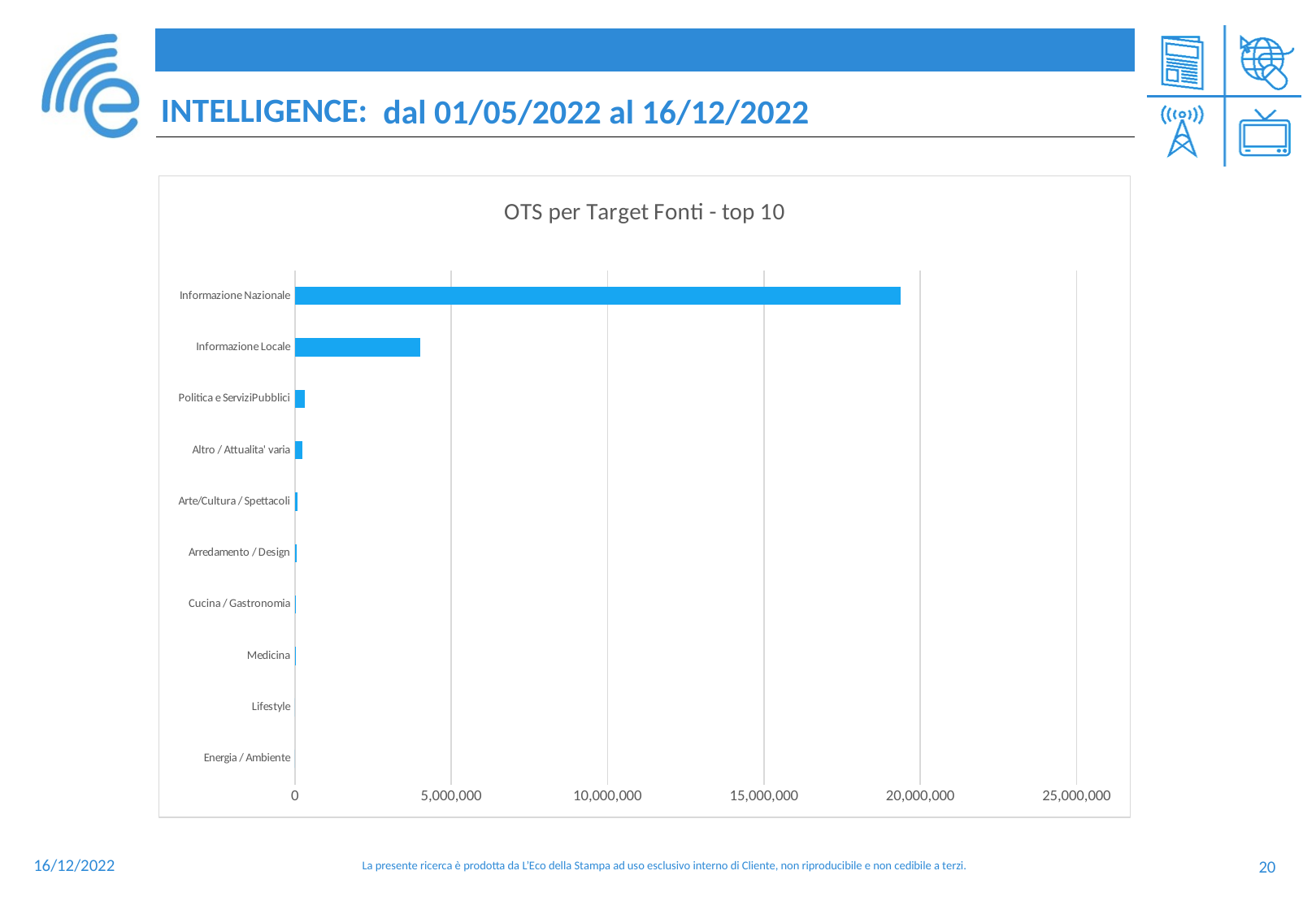
Which is larger, the value for Informazione Locale or the value for Altro / Attualita' varia? Informazione Locale Do the bar values increase or decrease going from the top category to the bottom category? decrease What kind of chart is shown on the slide? bar chart What is the title of the chart? OTS per Target Fonti - top 10 Is the value for Informazione Nazionale greater or less than 20,000,000? less Is the value for Informazione Nazionale greater or less than 15,000,000? greater Which category has the highest value? Informazione Nazionale Which is larger, the value for Informazione Nazionale or the value for Informazione Locale? Informazione Nazionale Is the value for Politica e ServiziPubblici greater or less than 5,000,000? less What is the highest value shown on the horizontal axis? 25,000,000 How many categories are plotted in the chart? 10